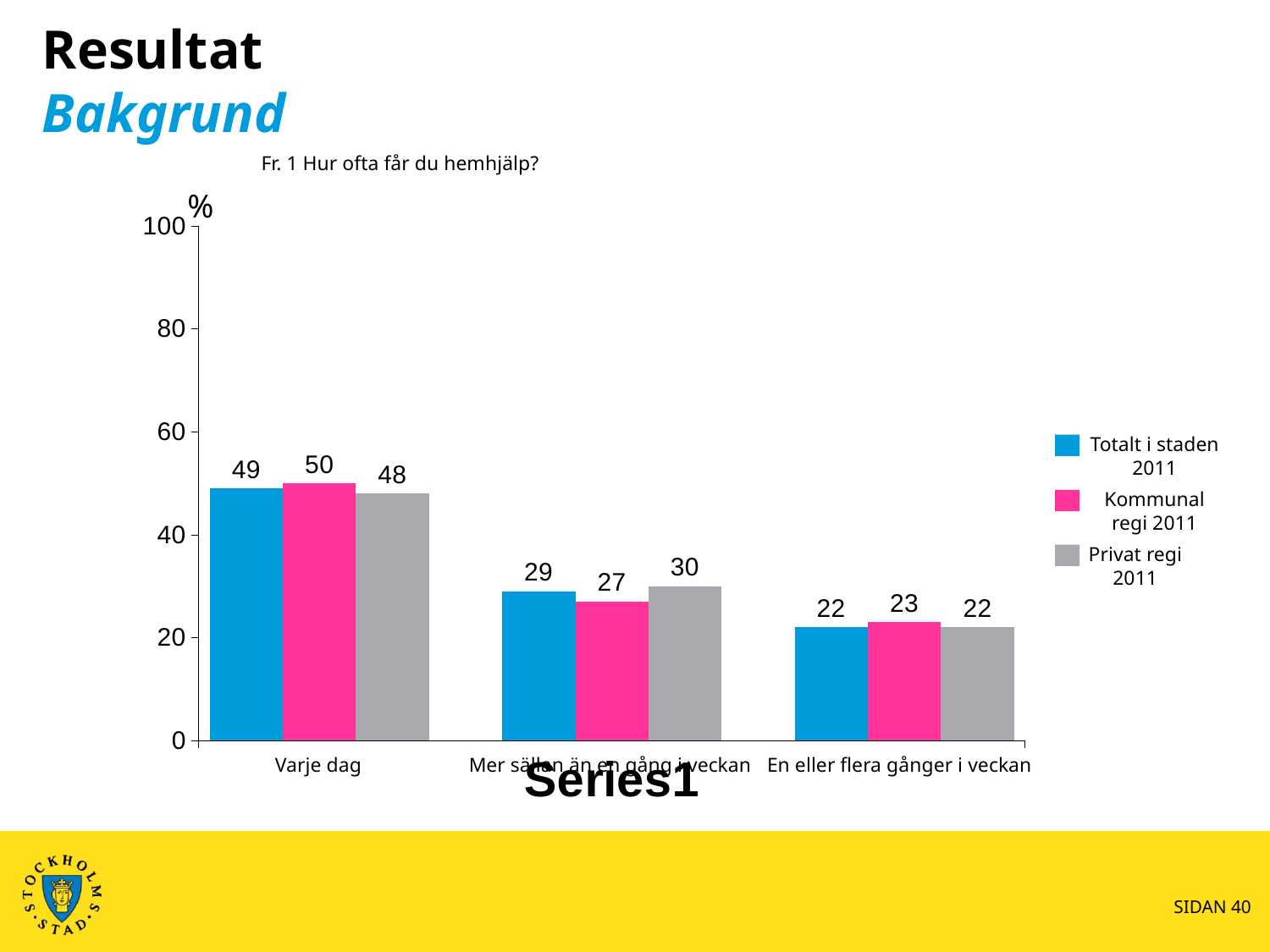
What is the value for Kommunal regi 2011 in the Mer sällan än en gång i veckan category? 27 What is the difference between the Privat regi 2011 value and the Kommunal regi 2011 value in the Mer sällan än en gång i veckan category? 3 How many series does the legend list? 3 What is the title of the chart? Fr. 1 Hur ofta får du hemhjälp? What is the value for Privat regi 2011 in the En eller flera gånger i veckan category? 22 In the Varje dag category, which is larger: Kommunal regi 2011 or Privat regi 2011? Kommunal regi 2011 What is the value for Totalt i staden 2011 in the Varje dag category? 49 Is the value for Totalt i staden 2011 in the Varje dag category greater or less than 40? greater How many categories are shown on the x axis? 3 Which category has the highest value for Kommunal regi 2011? Varje dag Which category has the lowest value for Totalt i staden 2011? En eller flera gånger i veckan What kind of chart is shown on the slide? Bar chart